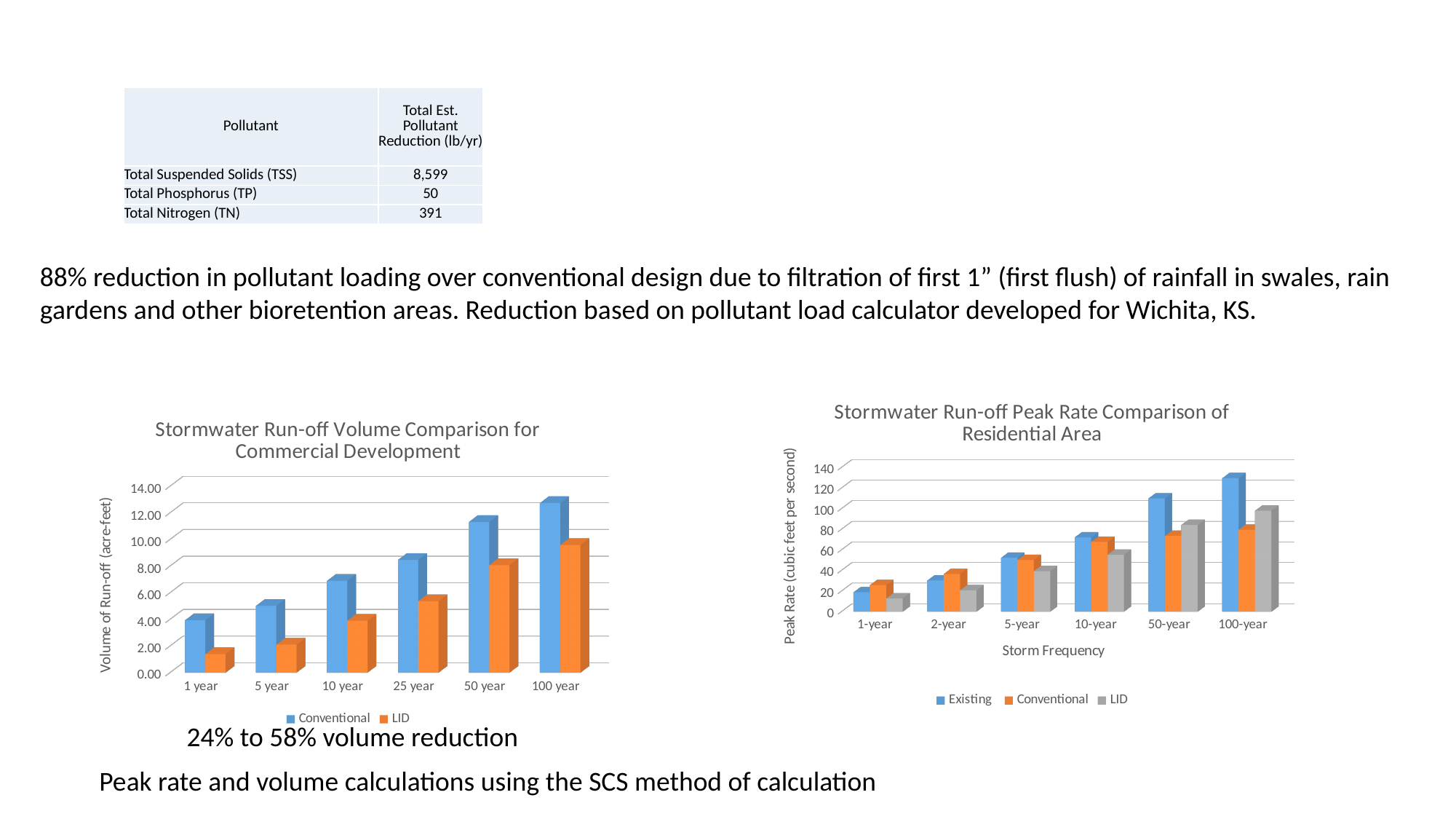
What kind of chart is the 'Stormwater Run-off Volume Comparison for Commercial Development' chart? bar chart In the 'Stormwater Run-off Volume Comparison for Commercial Development' chart, how many storm categories are shown on the x axis? 6 In the 'Stormwater Run-off Volume Comparison for Commercial Development' chart, is the Conventional value for 100 year greater or less than 12.00? greater In the 'Stormwater Run-off Peak Rate Comparison of Residential Area' chart, which is larger for 100-year: Existing or Conventional? Existing In the 'Stormwater Run-off Peak Rate Comparison of Residential Area' chart, how many series does the legend list? 3 In the 'Stormwater Run-off Peak Rate Comparison of Residential Area' chart, is the Existing value for 100-year greater or less than 120? greater In the 'Stormwater Run-off Volume Comparison for Commercial Development' chart, is the LID value for 1 year greater or less than 2.00? less In the 'Stormwater Run-off Volume Comparison for Commercial Development' chart, do the Conventional values rise or fall from 1 year to 100 year? rise In the 'Stormwater Run-off Peak Rate Comparison of Residential Area' chart, what is the title of the x axis? Storm Frequency In the 'Stormwater Run-off Volume Comparison for Commercial Development' chart, which storm category has the highest Conventional value? 100 year In the 'Stormwater Run-off Volume Comparison for Commercial Development' chart, how many series does the legend list? 2 In the 'Stormwater Run-off Volume Comparison for Commercial Development' chart, which is larger for 50 year: Conventional or LID? Conventional